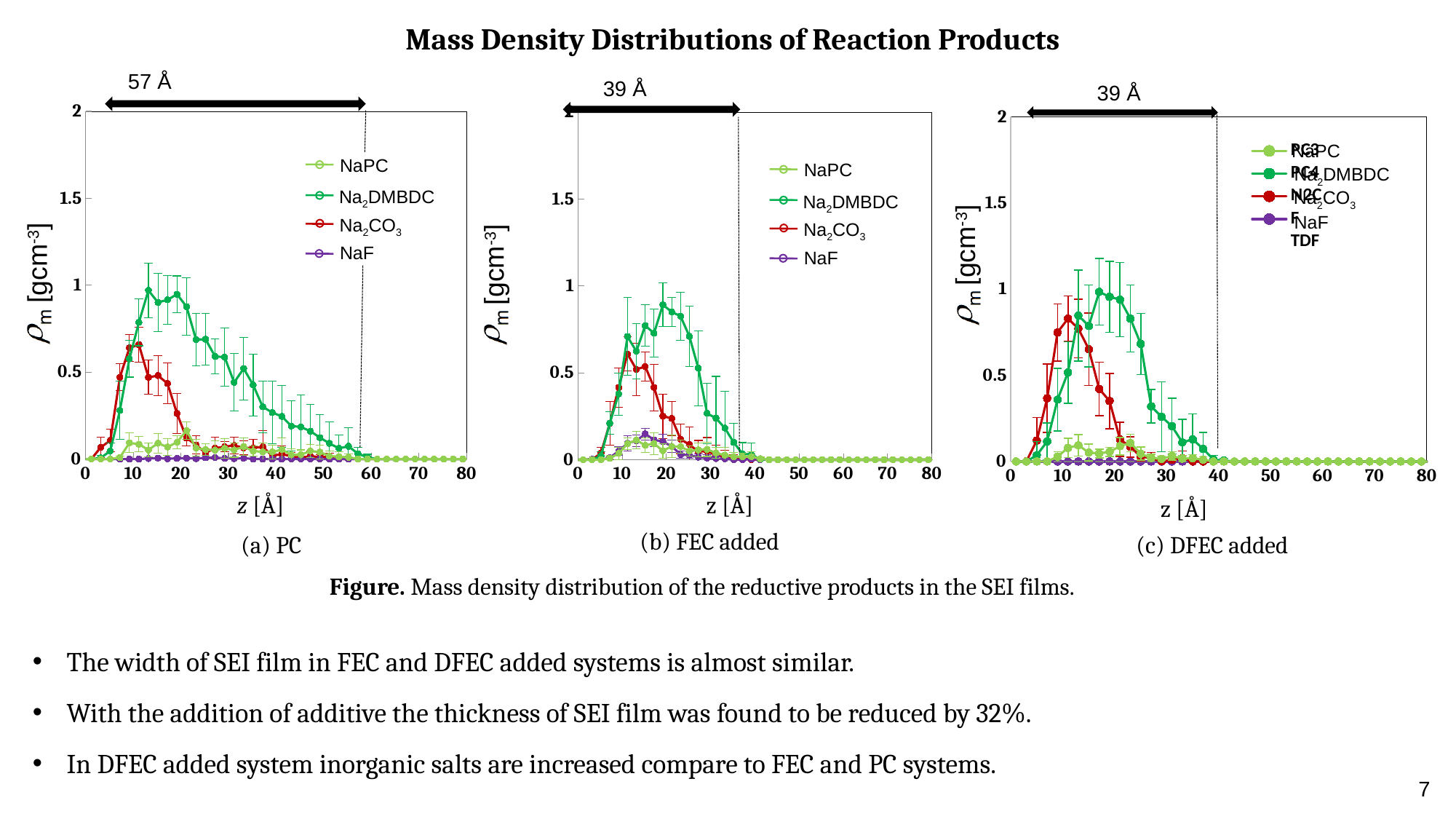
In panel (b) FEC added, which series has the higher peak, Na2CO3 or NaF? Na2CO3 In panel (a) PC, which series reaches the highest peak density? Na2DMBDC In panel (a) PC, which series stays lowest across the whole z range? NaF How many charts are shown on the slide? 3 In panel (a) PC, is the peak value of Na2DMBDC greater or less than 0.5? greater In panel (c) DFEC added, what SEI film width is marked by the arrow above the chart? 39 Å In panel (a) PC, what SEI film width is marked by the arrow above the chart? 57 Å In panel (b) FEC added, which series reaches the highest peak density? Na2DMBDC What kind of chart is panel (a) PC? line chart In panel (c) DFEC added, is the peak value of Na2CO3 greater or less than 0.5? greater How many series does the legend of panel (b) FEC added list? 4 In panel (a) PC, does the Na2DMBDC density rise or fall as z increases from 20 to 60 Å? fall